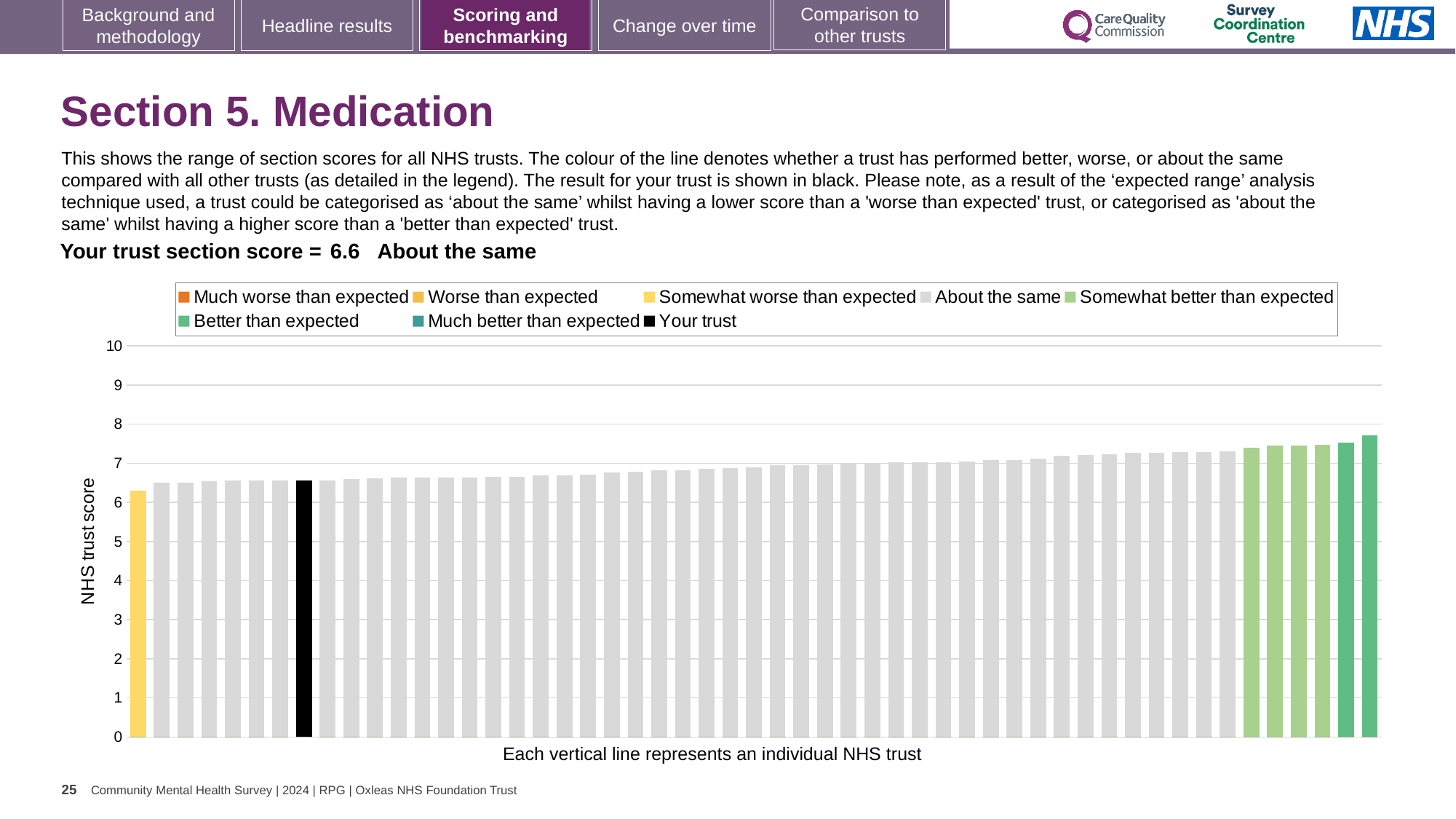
Is the value of the tallest bar (rightmost) greater or less than 7? greater Do the bar values rise or fall from left to right along the x axis? Rise Which bar has the highest value: the leftmost bar or the rightmost bar? Rightmost bar What is the section score for your trust shown on the slide? 6.6 Is the value of the leftmost (yellow) bar greater or less than 7? less What is the highest value shown on the vertical axis? 10 What colour is the bar representing your trust? Black What kind of chart is shown on the slide? Bar chart Is the value for your trust (the black bar) greater or less than 5? greater What is the label on the vertical axis of the chart? NHS trust score How many entries does the chart legend list? 8 Which category is your trust placed in for this section? About the same